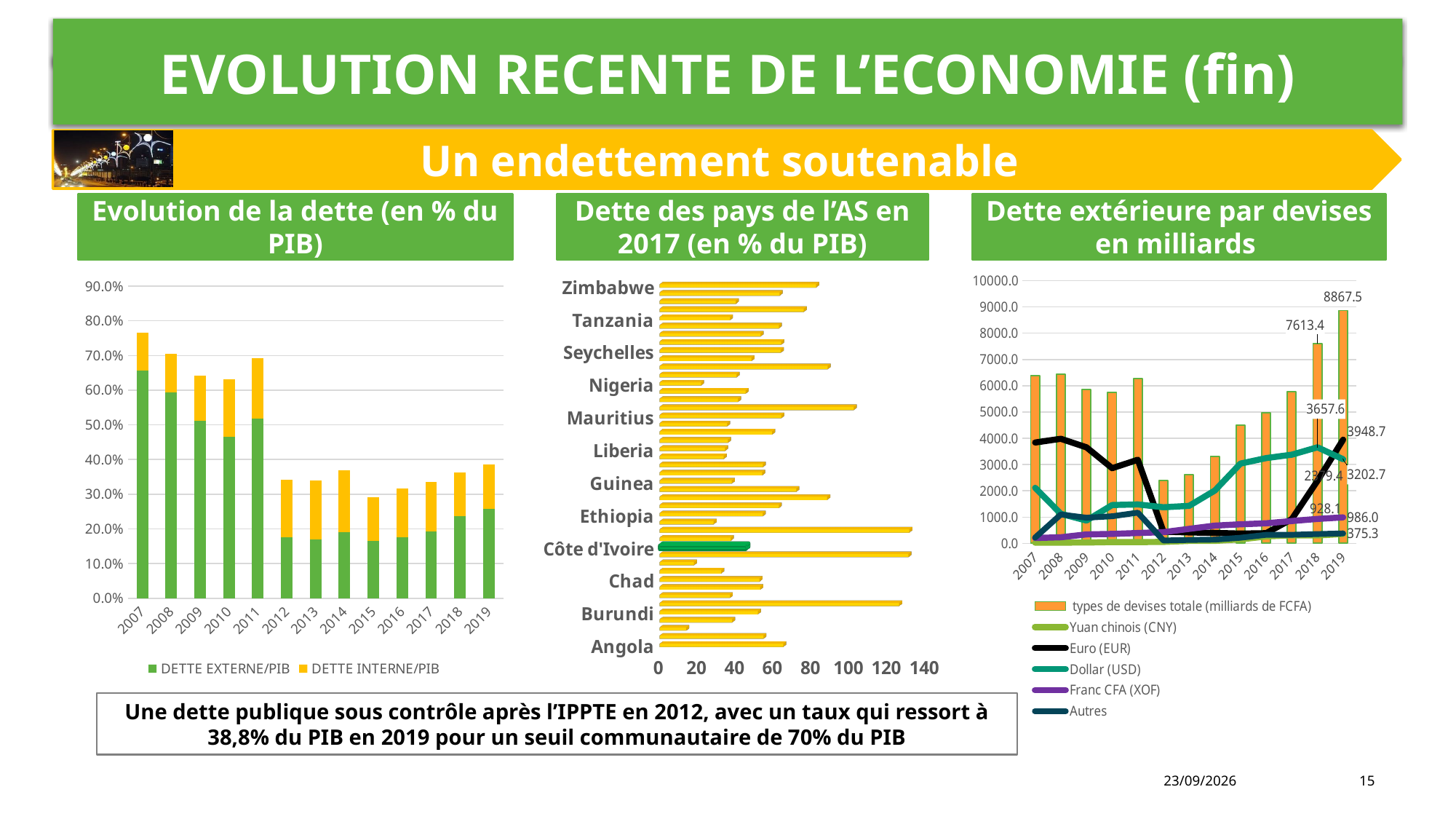
What kind of chart is 'Dette des pays de l'AS en 2017 (en % du PIB)'? bar chart In 'Evolution de la dette (en % du PIB)', which year has the lowest total bar? 2015 In 'Dette des pays de l'AS en 2017 (en % du PIB)', is the value for Côte d'Ivoire greater or less than 60? less In 'Evolution de la dette (en % du PIB)', do the total bars rise or fall from 2015 to 2019? rise What kind of chart is 'Evolution de la dette (en % du PIB)'? bar chart In 'Dette extérieure par devises en milliards', what is the value of 'types de devises totale' for 2019? 8867.5 How many series does the legend of 'Evolution de la dette (en % du PIB)' list? 2 In 'Dette extérieure par devises en milliards', what is the difference between the 'types de devises totale' values for 2019 and 2018? 1254.1 How many series does the legend of 'Dette extérieure par devises en milliards' list? 6 In 'Evolution de la dette (en % du PIB)', is the total bar for 2007 greater or less than 70.0%? greater How many years are shown on the x axis of 'Evolution de la dette (en % du PIB)'? 13 In 'Evolution de la dette (en % du PIB)', which year has the highest total bar? 2007